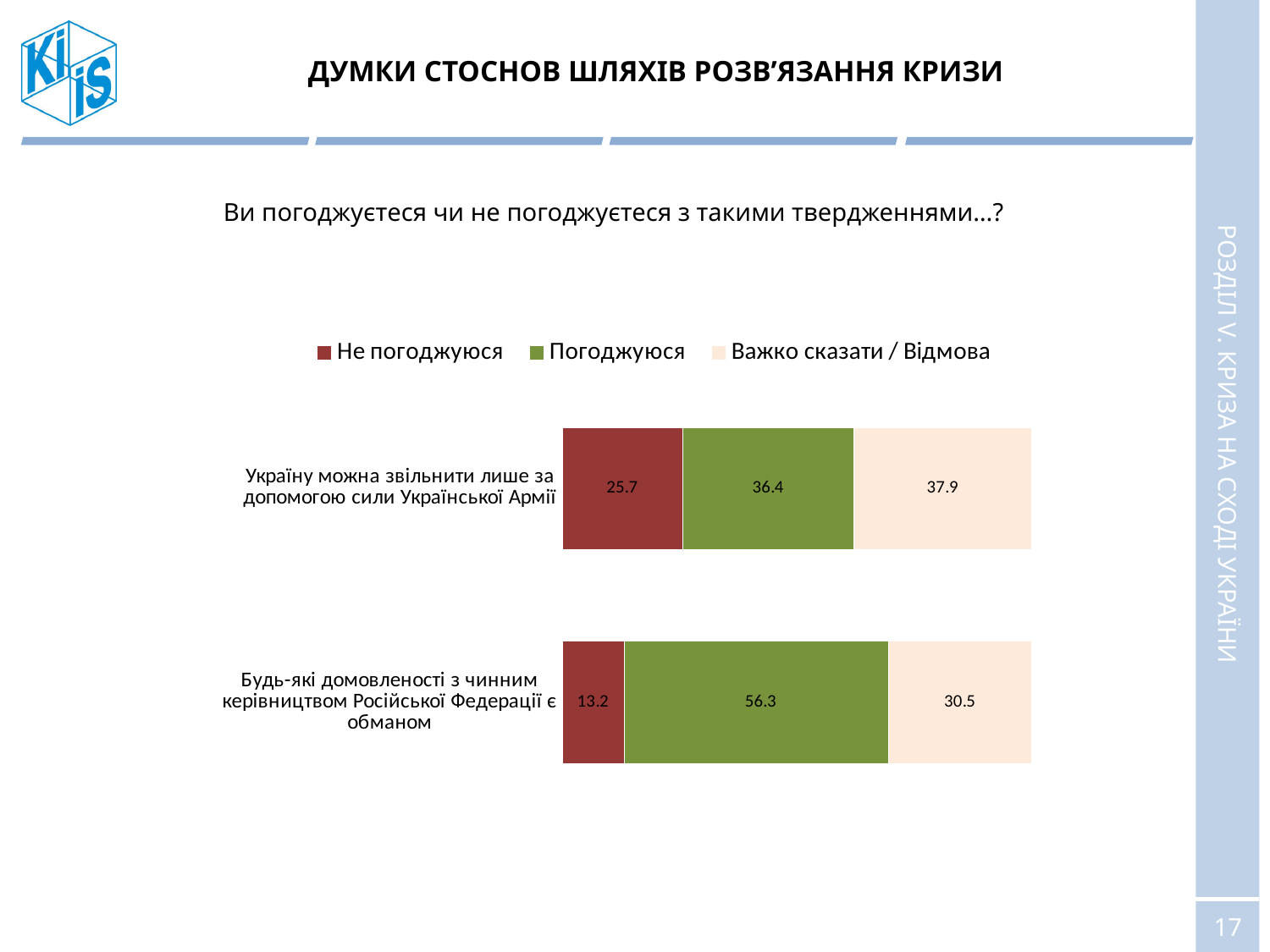
Which legend entry is shown in green? Погоджуюся What is the total of the stacked bar for "Будь-які домовленості з чинним керівництвом Російської Федерації є обманом"? 100.0 How many series does the legend list? 3 What is the value for "Не погоджуюся" for the statement "Будь-які домовленості з чинним керівництвом Російської Федерації є обманом"? 13.2 What is the difference between the "Погоджуюся" values of the two statements? 19.9 What is the value for "Погоджуюся" for the statement "Україну можна звільнити лише за допомогою сили Української Армії"? 36.4 Which statement has the higher "Погоджуюся" value? Будь-які домовленості з чинним керівництвом Російської Федерації є обманом How many statements (categories) are plotted in the chart? 2 Which statement has the lower "Не погоджуюся" value? Будь-які домовленості з чинним керівництвом Російської Федерації є обманом What is the value for "Важко сказати / Відмова" for the statement "Україну можна звільнити лише за допомогою сили Української Армії"? 37.9 For the statement "Україну можна звільнити лише за допомогою сили Української Армії", which is larger: "Не погоджуюся" or "Важко сказати / Відмова"? Важко сказати / Відмова What type of chart is shown on the slide? Stacked bar chart